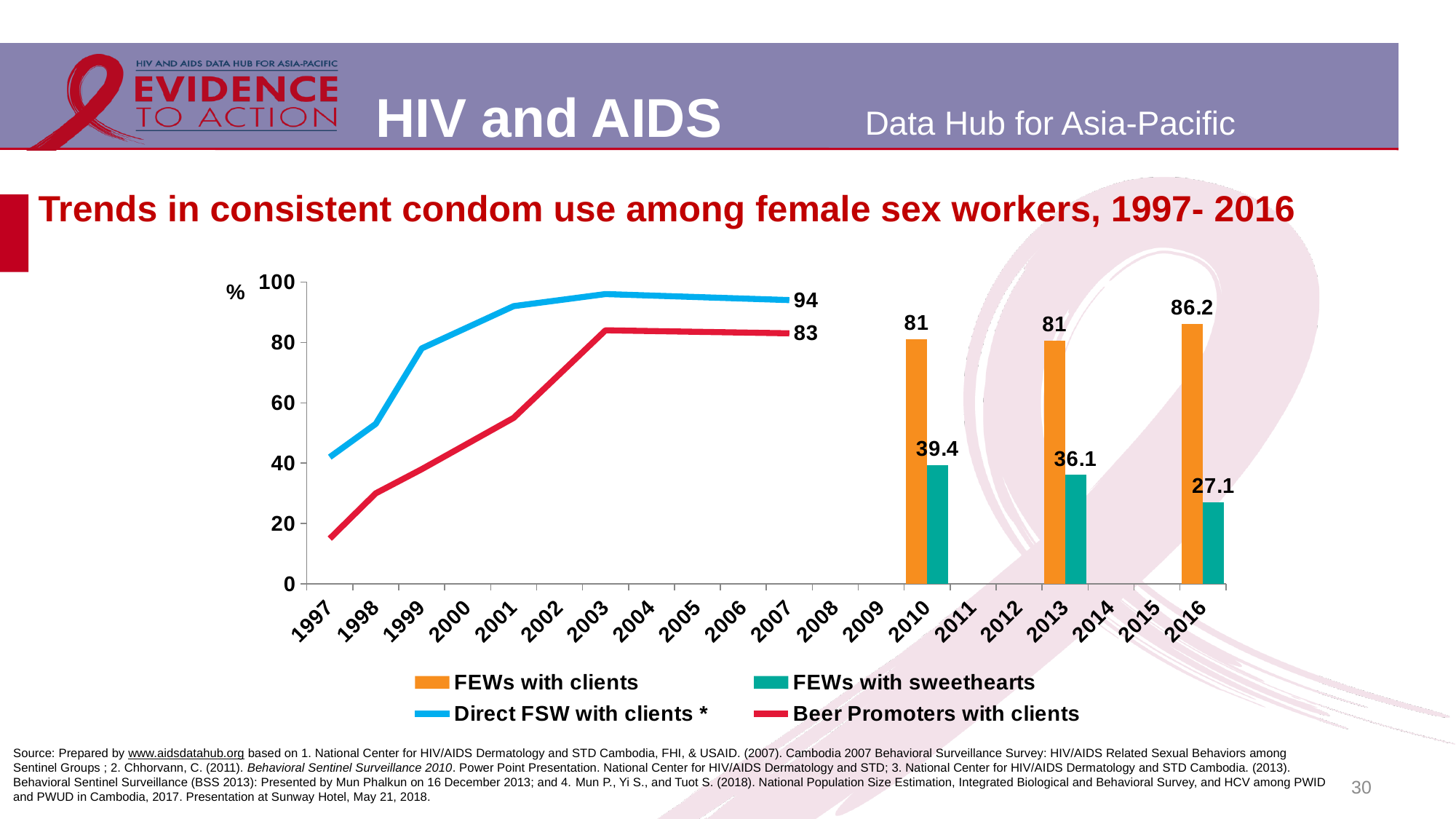
In which year is the value for FEWs with sweethearts lowest? 2016 Is the value for Direct FSW with clients in 1999 greater or less than 60? greater Does the Direct FSW with clients line rise or fall between 1997 and 2003? rise How many series does the legend list? 4 Is the value for Beer Promoters with clients in 1997 greater or less than 20? less What value is labelled at the end of the Direct FSW with clients line in 2007? 94 What is the value for FEWs with sweethearts in 2010? 39.4 What value is labelled at the end of the Beer Promoters with clients line in 2007? 83 Which is larger in 2016: FEWs with clients or FEWs with sweethearts? FEWs with clients What colour represents FEWs with sweethearts in the chart? Teal (green) What is the difference between FEWs with clients and FEWs with sweethearts in 2013? 44.9 What is the value for FEWs with clients in 2016? 86.2